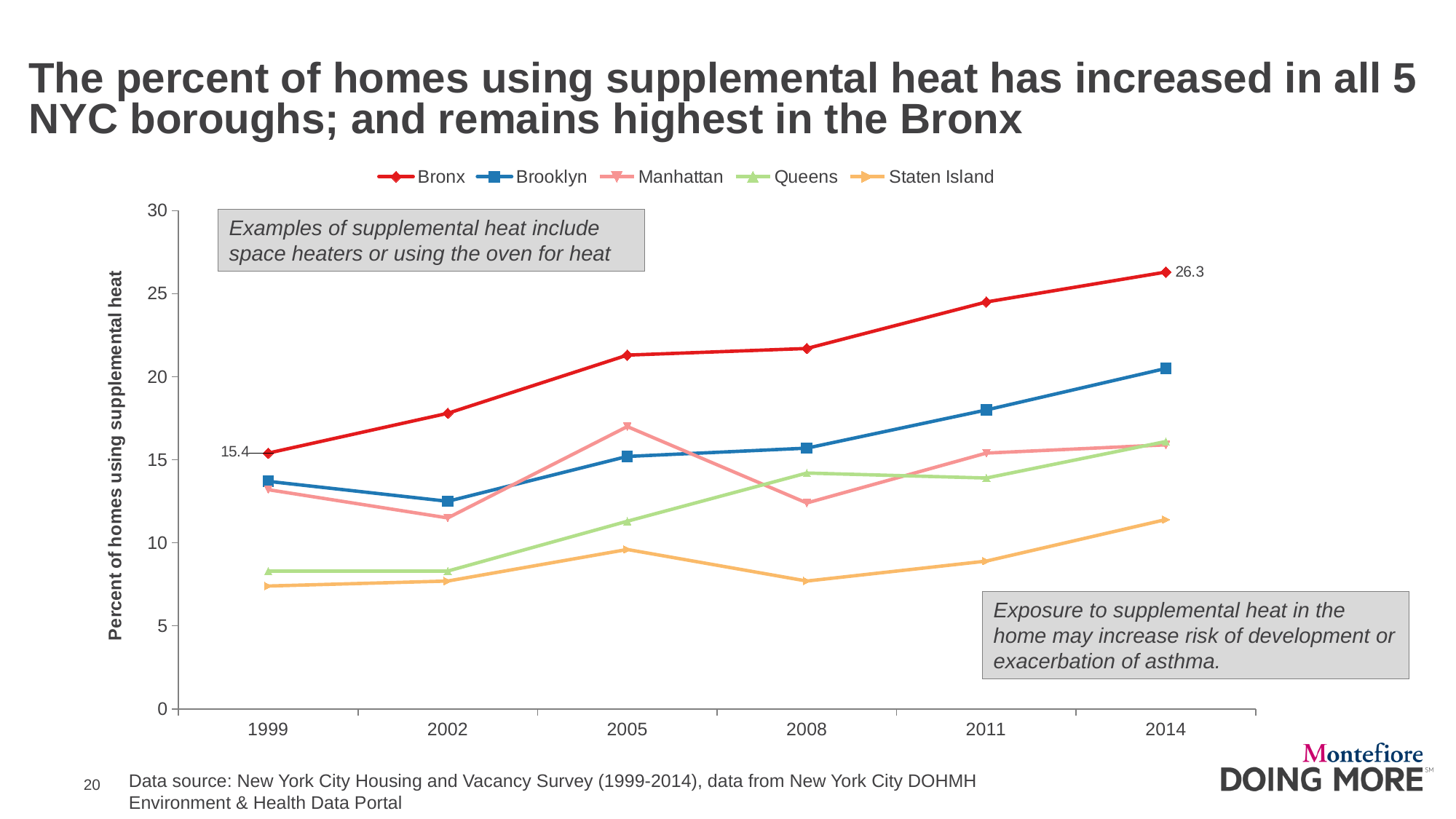
Which borough has the highest value in 2014? Bronx What is the value for the Bronx in 1999? 15.4 Does the Bronx line rise or fall from 1999 to 2014? Rises What is the value for the Bronx in 2014? 26.3 What kind of chart is shown on the slide? Line chart Is the value for Staten Island in 2008 greater or less than 10? less Is the value for the Bronx in 2011 greater or less than 20? greater In 2005, which is larger: the value for Manhattan or the value for Brooklyn? Manhattan How many series does the legend list? 5 By how much did the Bronx value increase from 1999 to 2014? 10.9 Which borough has the lowest value in 2014? Staten Island How many years are shown on the x axis? 6